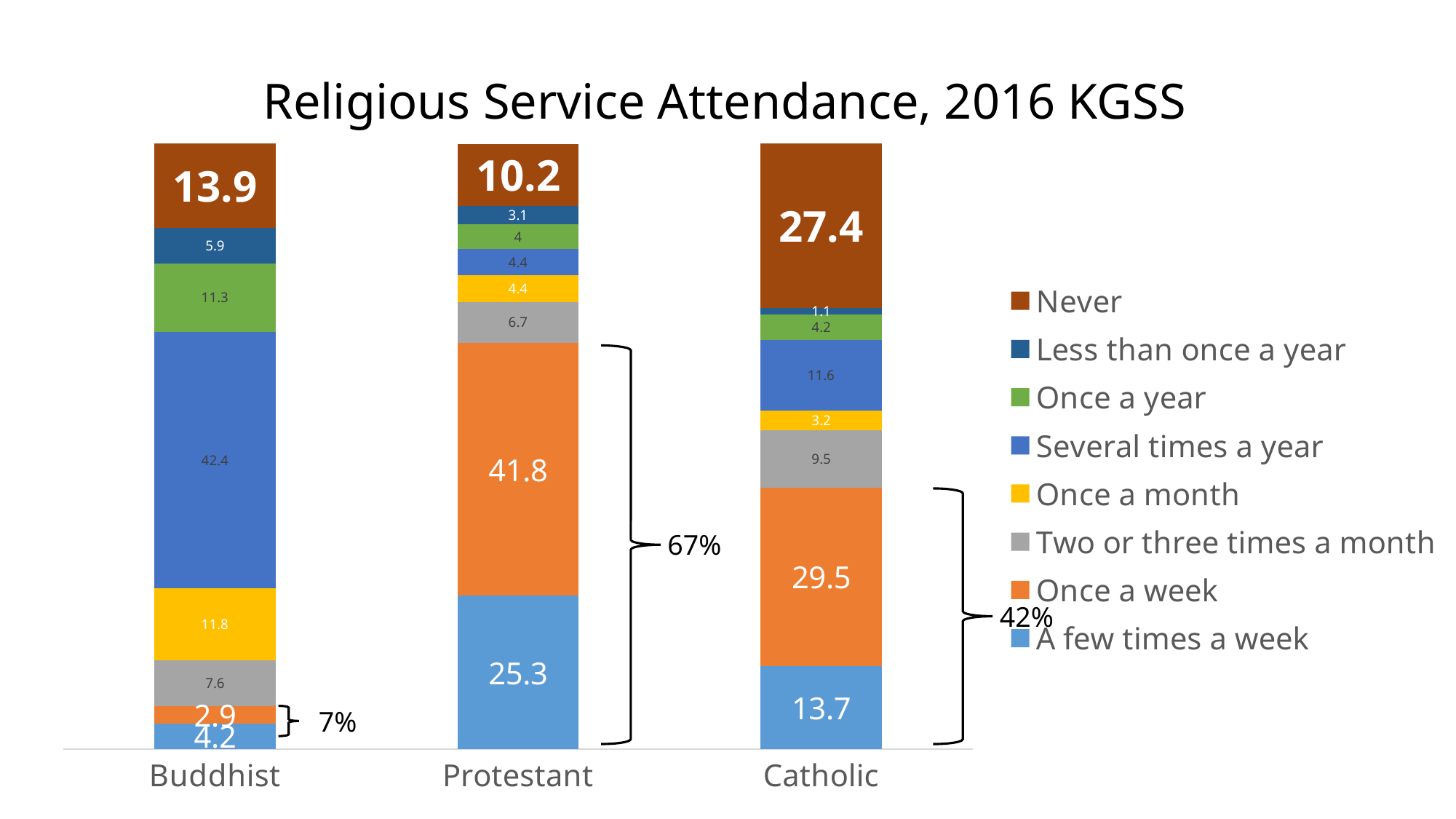
Which religious group has the lowest value for Once a week? Buddhist What is the value for Never in the Catholic bar? 27.4 What kind of chart is shown on the slide? Stacked bar chart How many religious groups are shown on the x axis? 3 How many series does the legend list? 8 What is the value for A few times a week in the Catholic bar? 13.7 Which is larger, the Once a week value for Protestant or for Catholic? Protestant What is the value for Several times a year in the Buddhist bar? 42.4 Which religious group has the highest value for Never? Catholic What is the title of the chart? Religious Service Attendance, 2016 KGSS What is the difference between the Never values for Catholic and Buddhist? 13.5 What is the value for Once a week in the Protestant bar? 41.8